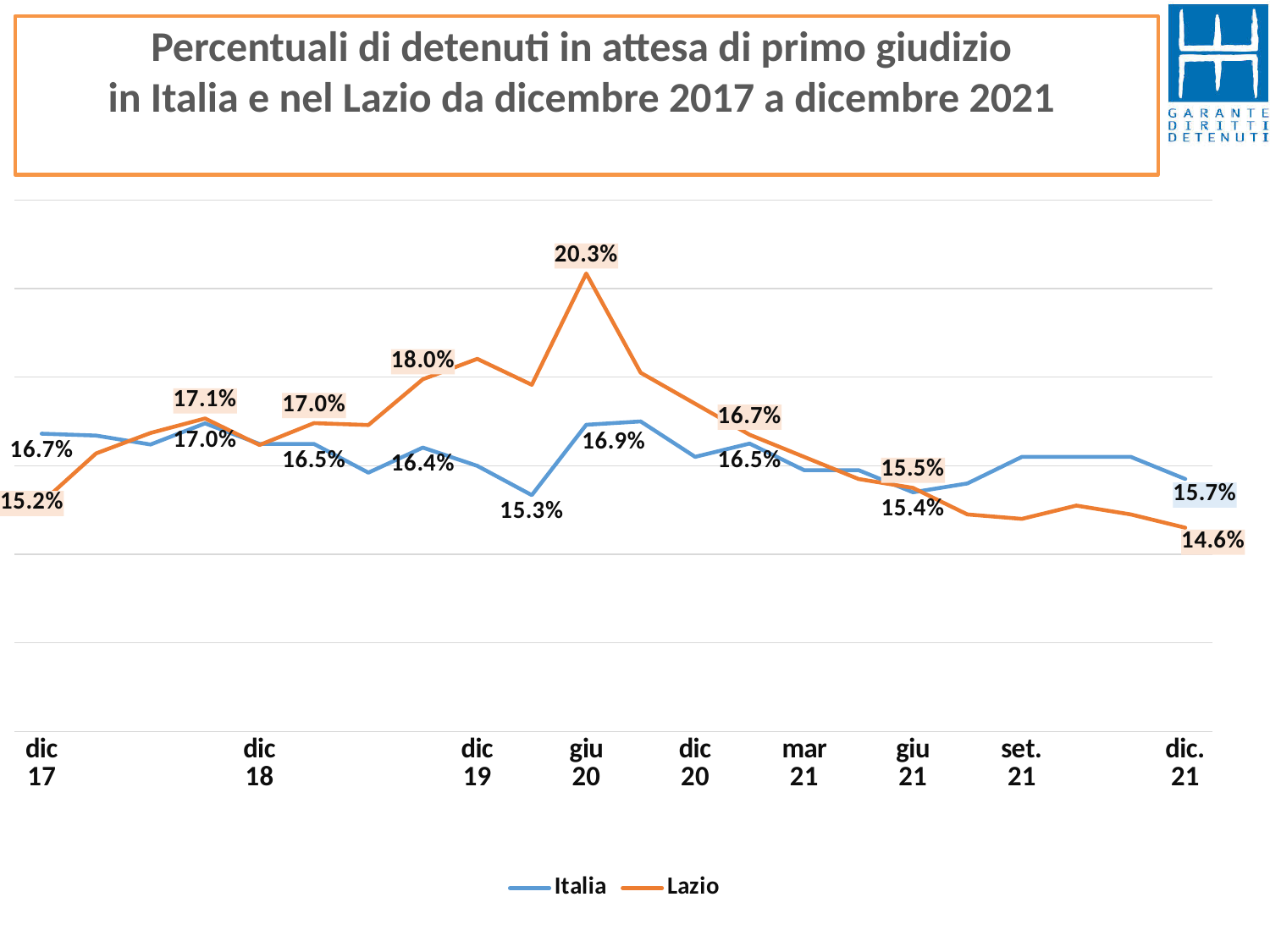
What is the lowest value shown for the Italia series? 15.3% What kind of chart is shown on the slide? line chart What is the value for Lazio at dic 21? 14.6% What is the highest value shown for the Lazio series? 20.3% What is the value for Italia at dic 17? 16.7% Which series is drawn in orange? Lazio What is the difference between the Lazio and Italia values at giu 20? 3.4 percentage points How many series does the legend list? 2 Does the Lazio line rise or fall from giu 20 to dic 21? fall What is the value for Lazio at giu 20? 20.3% At dic 17, which series has the higher value, Italia or Lazio? Italia